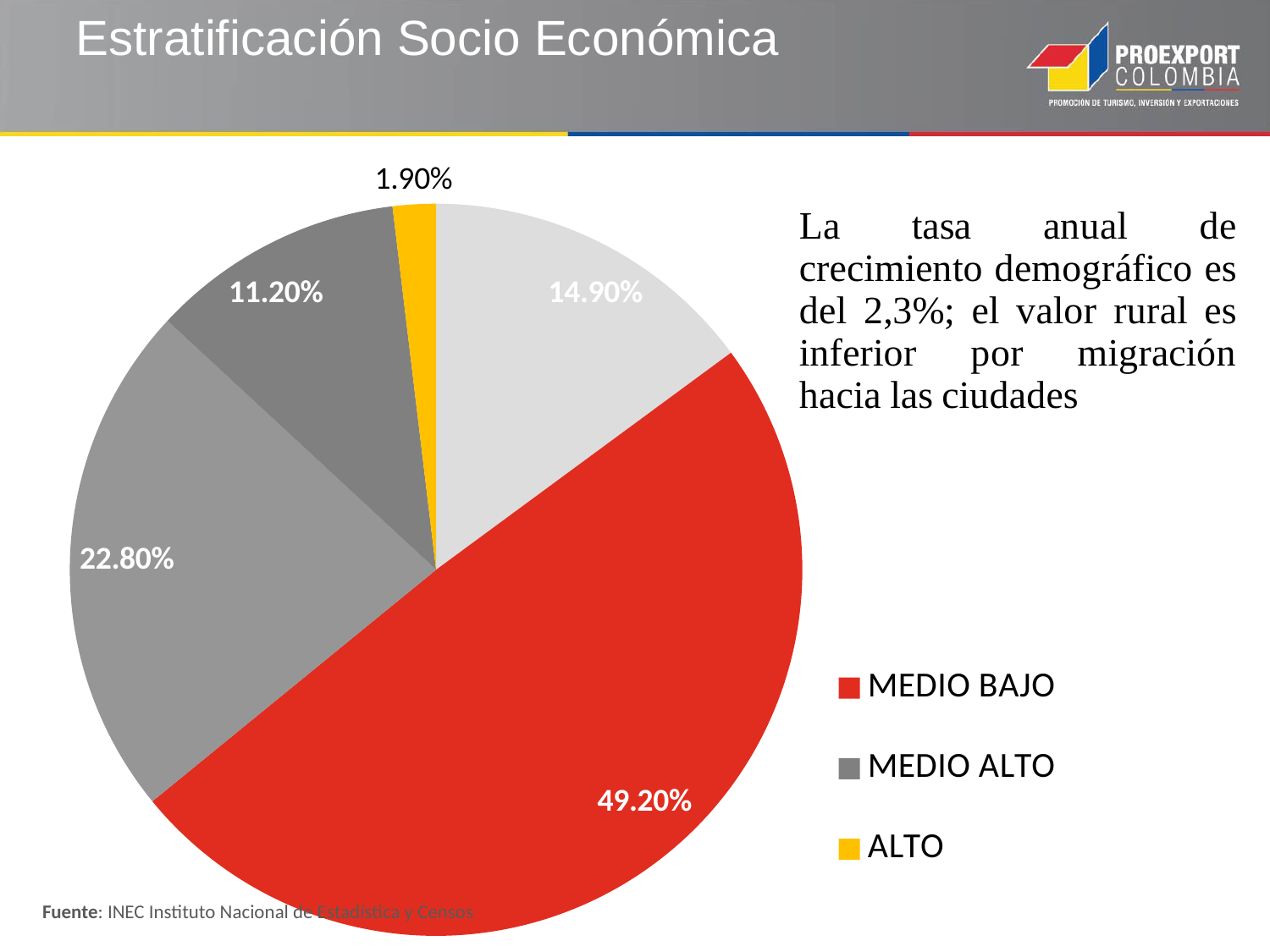
How many entries are listed in the chart legend? 3 What colour is the MEDIO BAJO slice? red What percentage does the MEDIO BAJO slice represent? 49.20% What percentage does the ALTO slice represent? 1.90% Which is larger, the MEDIO BAJO slice or the ALTO slice? MEDIO BAJO What is the difference between the two largest slices of the pie? 26.40% What type of chart is shown on the slide? pie chart What is the difference between the MEDIO BAJO share and the ALTO share? 47.30% What is the title of the slide containing the chart? Estratificación Socio Económica Which category has the largest slice of the pie? MEDIO BAJO Which category has the smallest slice of the pie? ALTO How many slices does the pie chart have? 5